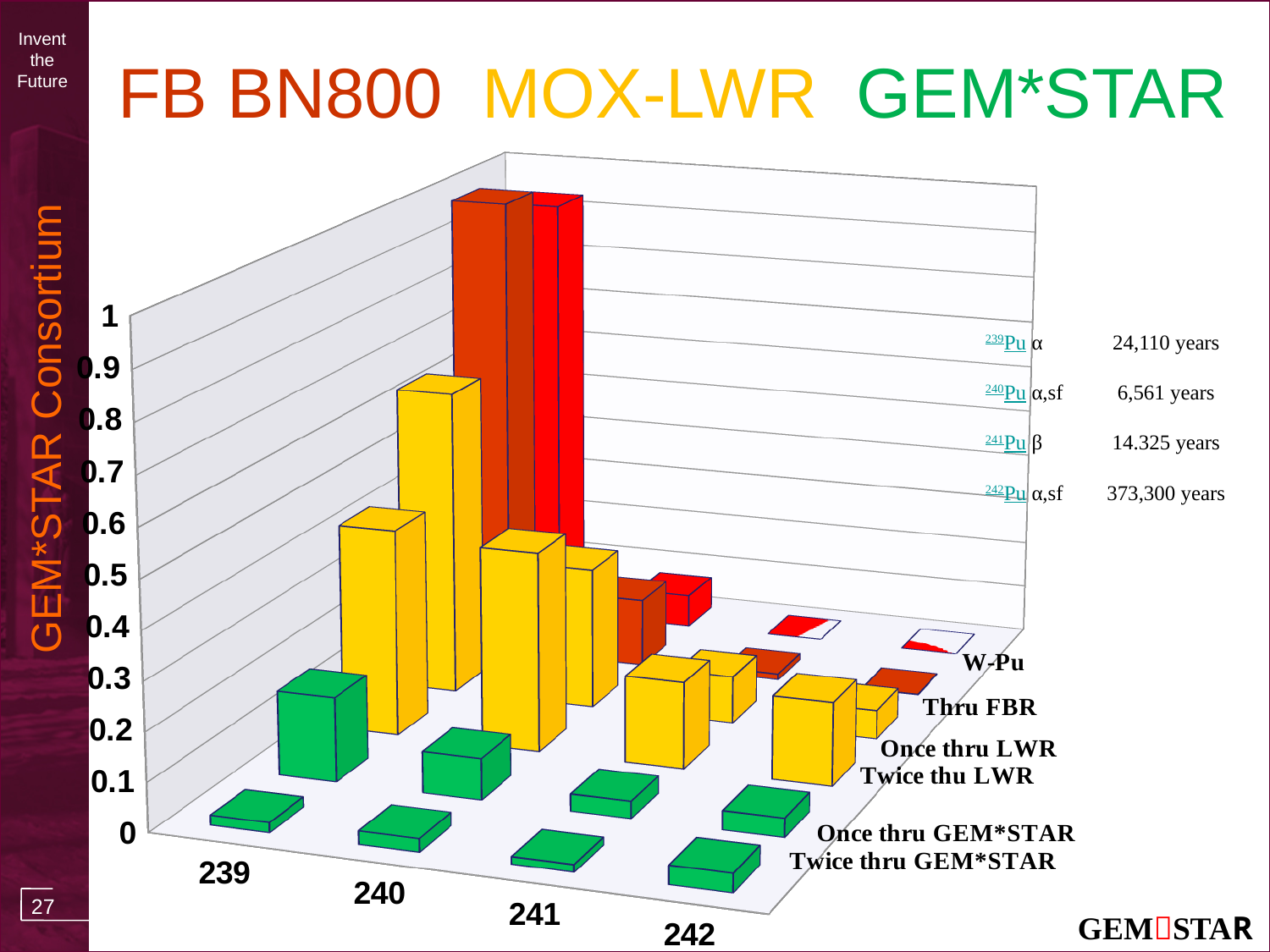
Which is larger at 239, the Once thru LWR value or the Once thru GEM*STAR value? Once thru LWR What kind of chart is shown on the slide? bar chart What is the maximum value shown on the vertical axis of the chart? 1 Do the W-Pu values rise or fall from 239 to 242? fall Is the W-Pu value for 239 greater or less than 0.5? greater Which isotope category has the tallest bar in the chart? 239 What colour are the GEM*STAR bars in the chart? green How many isotope categories are shown along the x axis of the chart? 4 Is the Twice thru GEM*STAR value for 239 greater or less than 0.2? less How many series (fuel cycle rows) are plotted in the chart? 6 Is the Once thru LWR value for 239 greater or less than 0.3? greater Which is larger, the W-Pu value for 239 or the W-Pu value for 242? 239